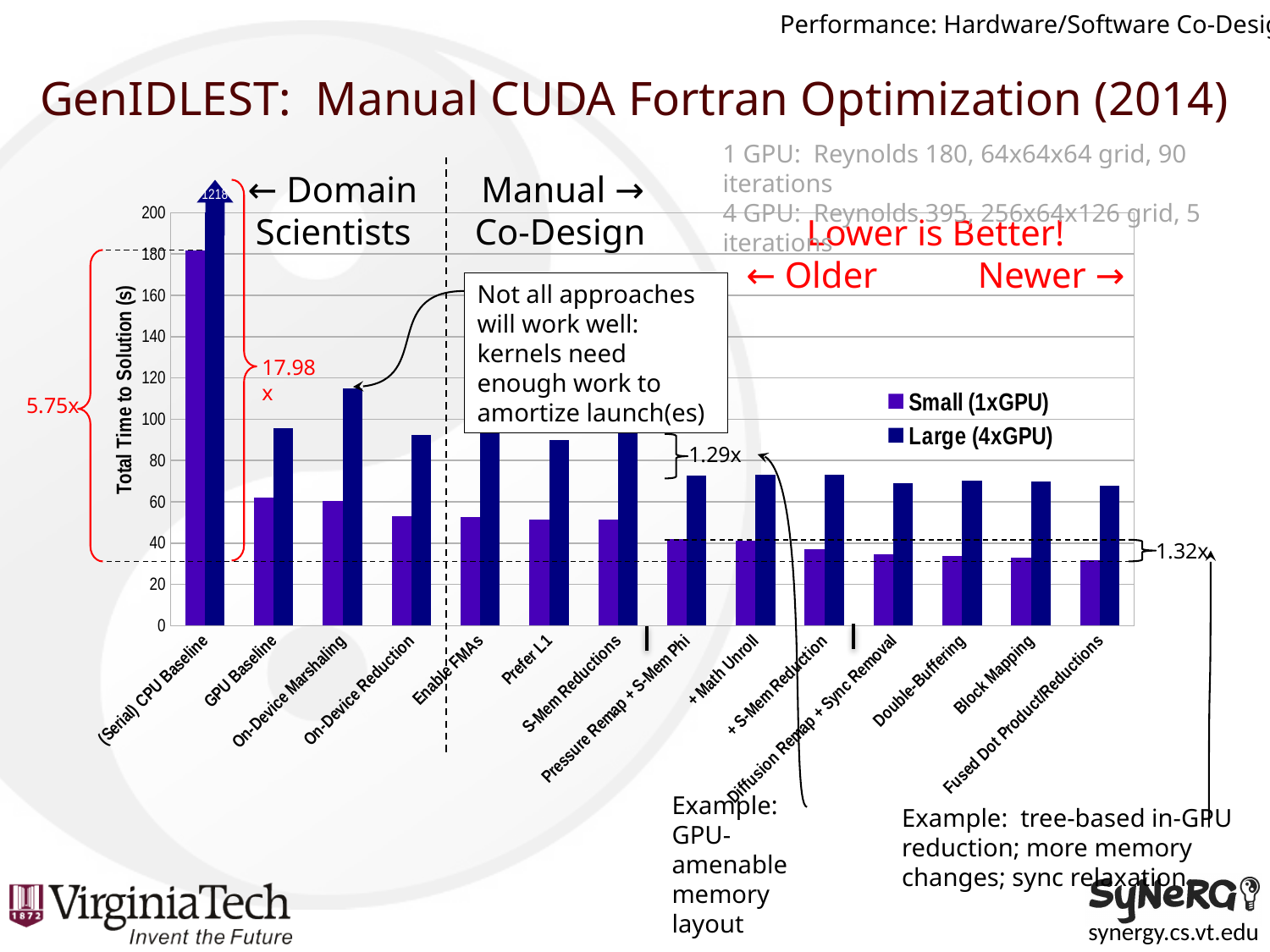
How many series does the chart legend list? 2 What is the title of the chart's y axis? Total Time to Solution (s) Which category has the highest Small (1xGPU) value? (Serial) CPU Baseline What kind of chart is shown on the slide? bar chart Do the Small (1xGPU) values generally rise or fall from left to right along the x axis? fall Is the Small (1xGPU) value for Fused Dot Product/Reductions greater or less than 40? less How many optimization categories are shown along the x axis of the chart? 14 What is the data label printed on the Large (4xGPU) bar for (Serial) CPU Baseline? 1218 Is the Small (1xGPU) value for (Serial) CPU Baseline greater or less than 160? greater Which is larger: the Large (4xGPU) value for On-Device Marshaling or for On-Device Reduction? On-Device Marshaling Is the Large (4xGPU) value for On-Device Marshaling greater or less than 100? greater